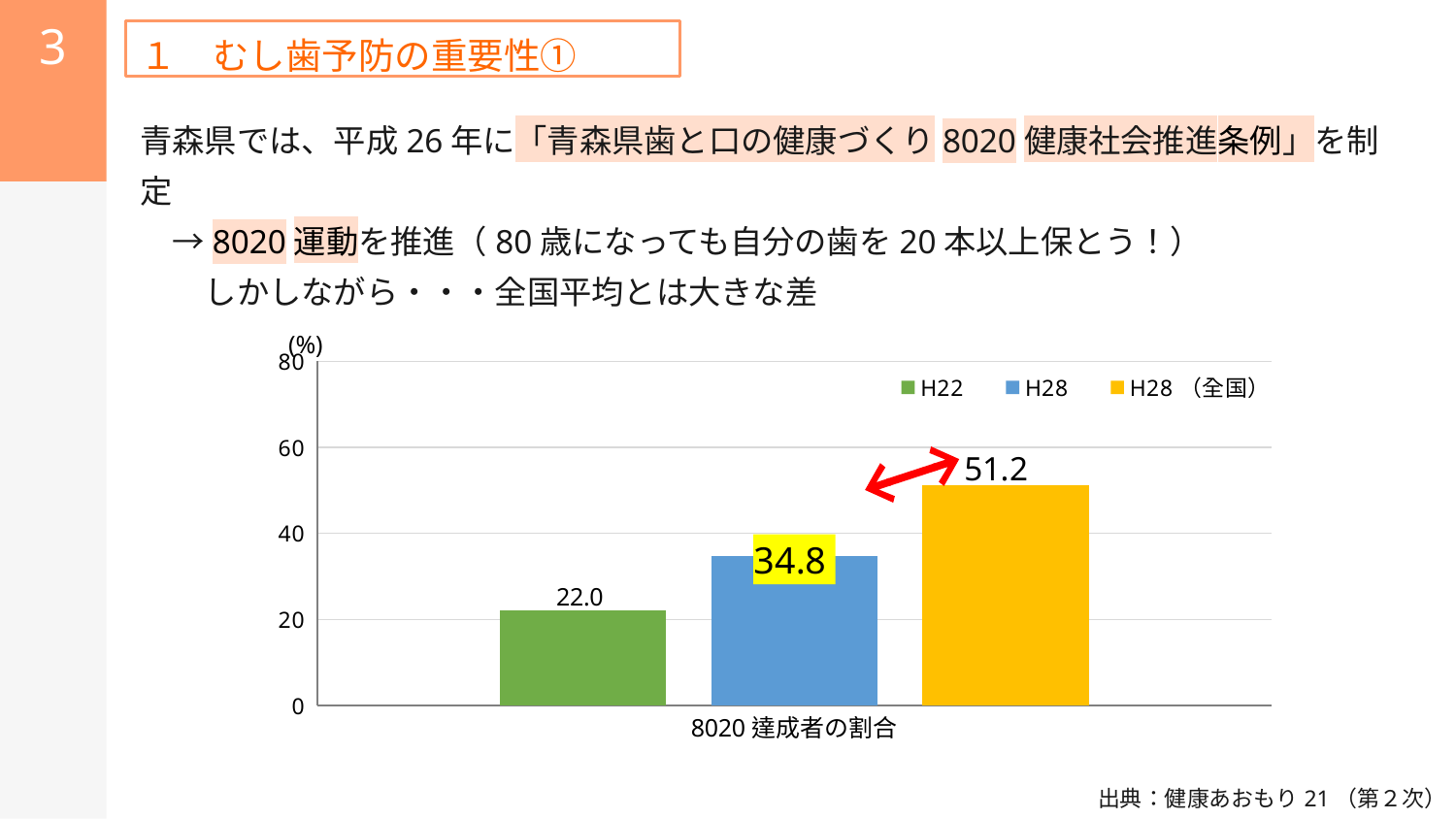
How many series does the legend list? 3 Which series has the lowest value in the chart? H22 What is the value for H28 in the chart? 34.8 What is the value for H22 in the chart? 22.0 What is the difference between the H28（全国） value and the H28 value? 16.4 What kind of chart is shown on the slide? bar chart What unit is shown at the top of the y axis? (%) What is the category label shown on the x axis of the chart? 8020達成者の割合 What is the value for H28（全国） in the chart? 51.2 Which series has the highest value in the chart? H28（全国） What is the difference between the H28 value and the H22 value? 12.8 Which is larger, the value for H22 or the value for H28? H28